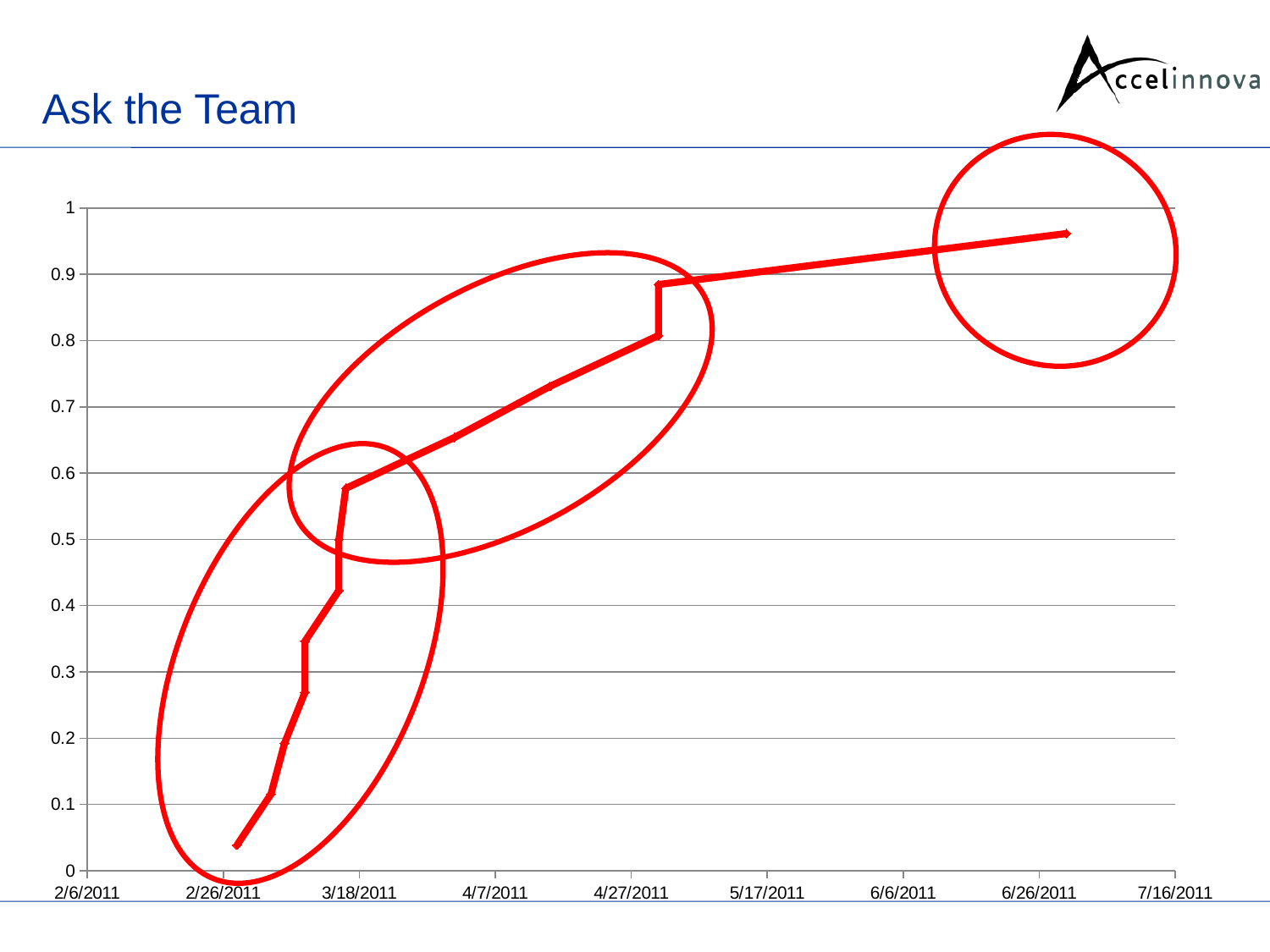
Is the value of the first point on the line (just after 2/26/2011) greater or less than 0.1? less What is the first date label on the x axis? 2/6/2011 What is the highest value shown on the y axis? 1 Is the value of the point just before 3/18/2011, at the top of the vertical segment, greater or less than 0.5? greater What is the last date label on the x axis? 7/16/2011 Do the plotted values rise or fall as the dates move from left to right along the x axis? rise How many date labels are shown along the x axis? 9 Is the value of the point just after 4/27/2011, at the top of the vertical jump, greater or less than 0.8? greater What is the title of the slide containing the chart? Ask the Team What kind of chart is shown on the slide? line chart